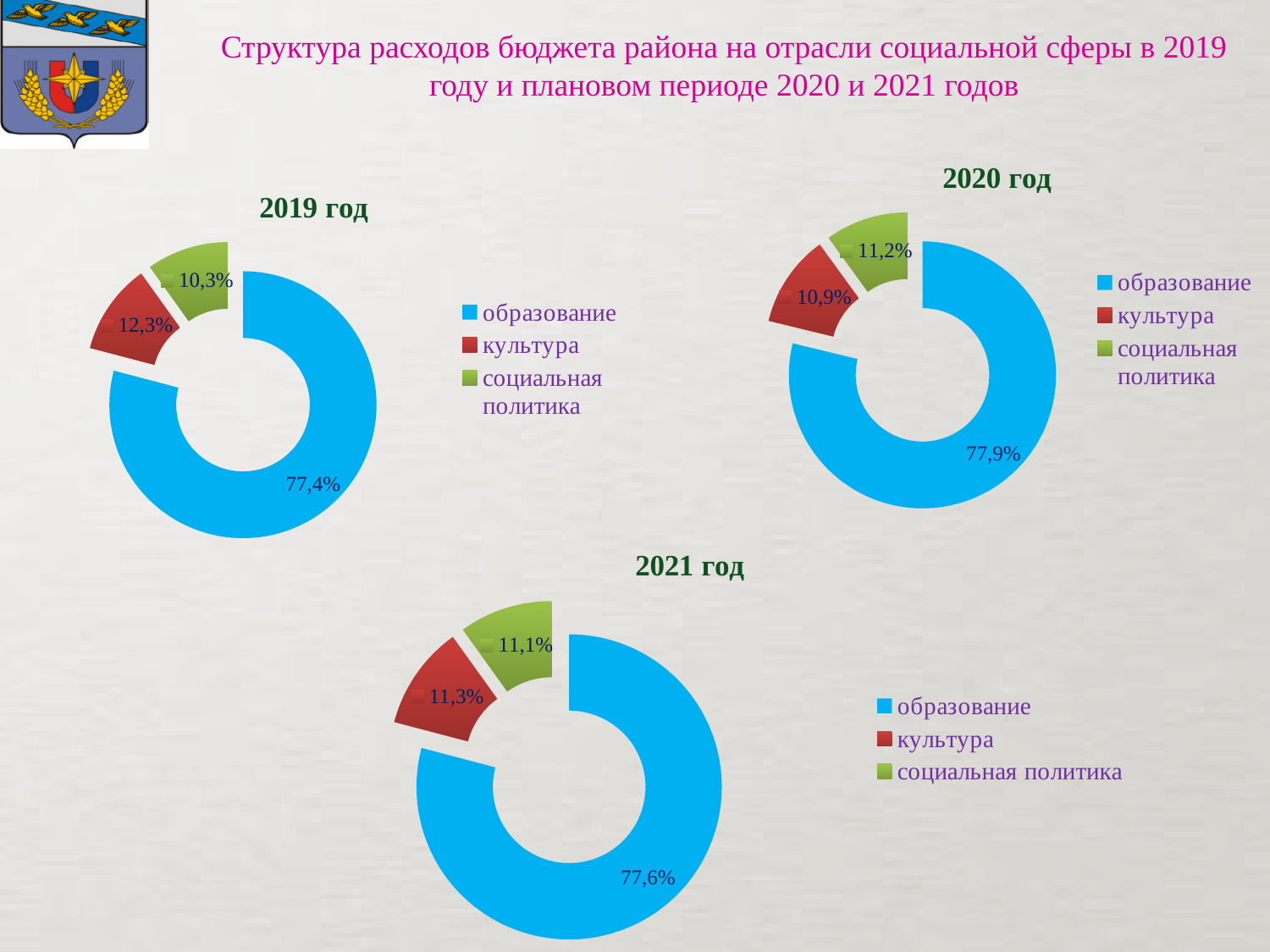
In the "2020 год" chart, what is the value for социальная политика? 11,2% In the "2020 год" chart, which category has the largest share? образование In the "2020 год" chart, which is larger: культура or социальная политика? социальная политика In the "2019 год" chart, which category has the smallest share? социальная политика In the "2021 год" chart, what is the value for культура? 11,3% How many charts are on the slide? 3 In the "2021 год" chart, what is the difference between the values for образование and культура? 66,3% What kind of chart is the "2019 год" chart? doughnut chart In the "2019 год" chart, what is the difference between the values for культура and социальная политика? 2,0% How many categories does the "2021 год" chart show? 3 In the "2019 год" chart, what is the value for культура? 12,3% In the "2019 год" chart, what is the value for образование? 77,4%